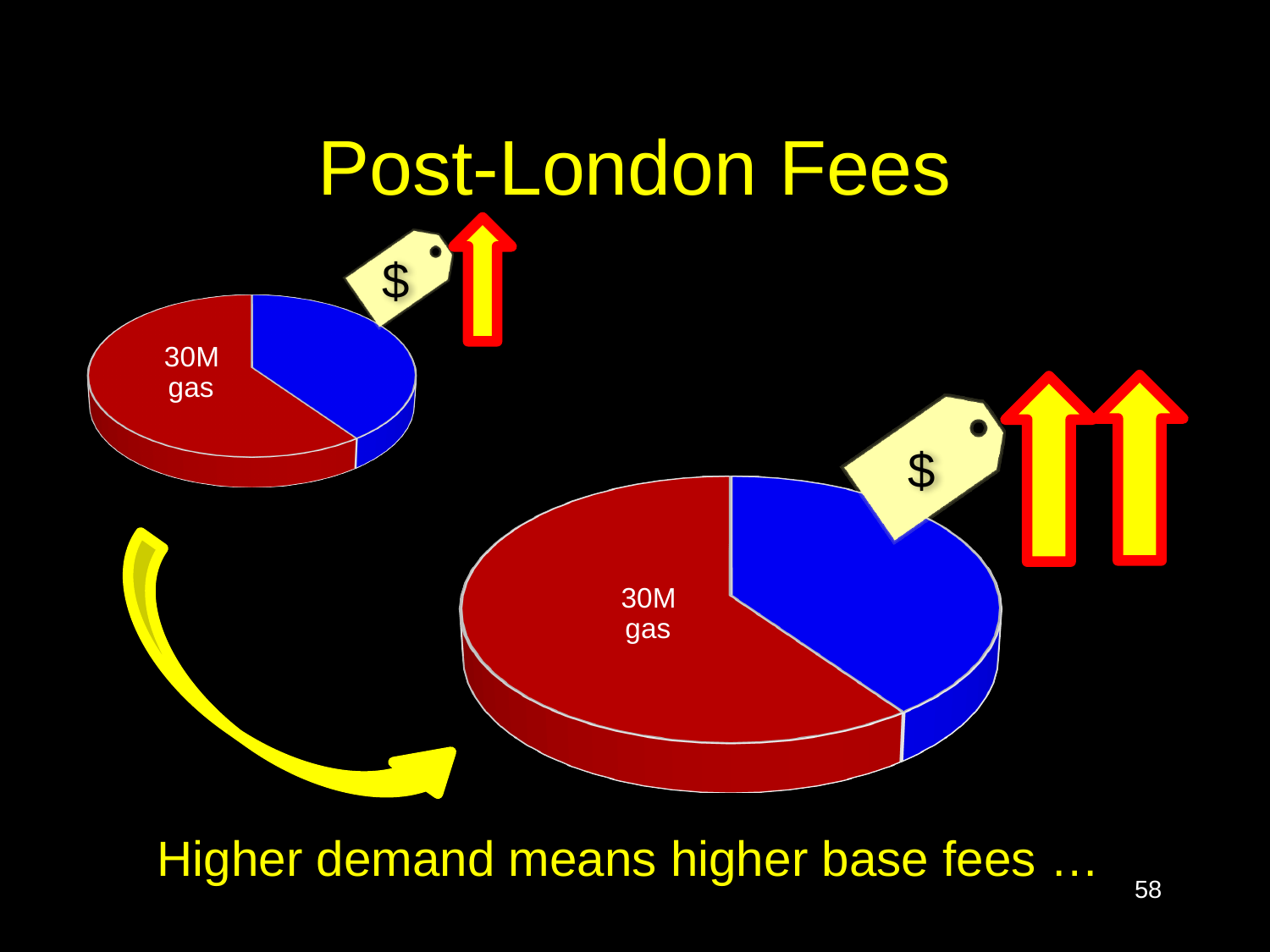
How many pie charts are shown on the slide? 2 What kind of chart is the larger chart on the right of the slide? Pie chart How many slices does the smaller pie chart on the left have? 2 In the larger pie chart on the right, which slice is larger, the red one or the blue one? The red one What colour is the slice labelled "30M gas" in the larger pie chart on the right? Red What label is printed on the red slice of the larger pie chart on the right? 30M gas How many slices does the larger pie chart on the right have? 2 What kind of chart is the smaller chart on the left of the slide? Pie chart What is the title of the slide containing the pie charts? Post-London Fees What label is printed on the red slice of the smaller pie chart on the left? 30M gas In the smaller pie chart on the left, which slice is larger, the red one or the blue one? The red one